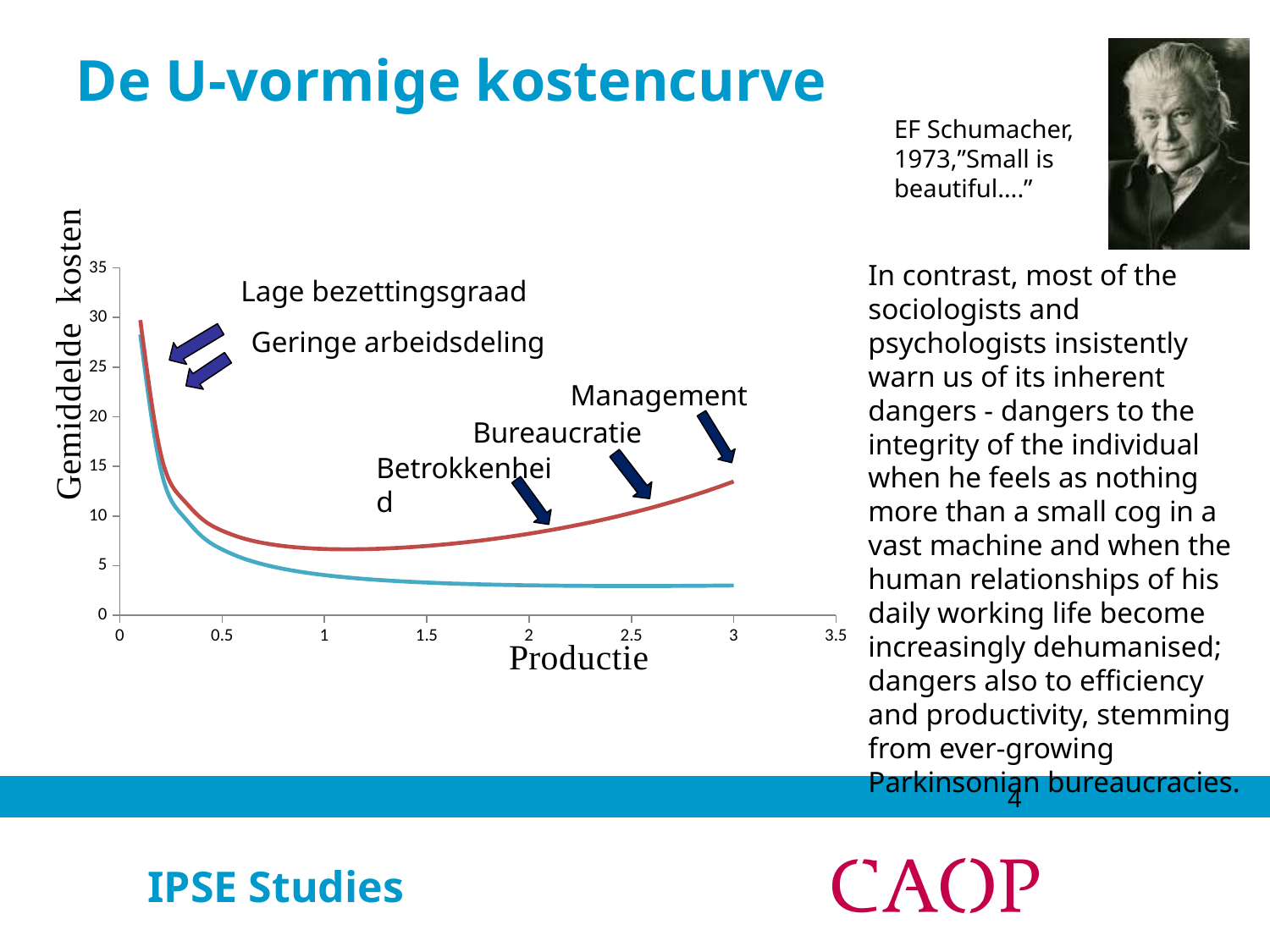
What is the label of the x axis of the chart? Productie Is the value of the blue curve at Productie 2 greater or less than 5? less What is the highest tick value shown on the y axis? 35 Is the value of the red curve at Productie 3 greater or less than 10? greater How many curves are plotted on the chart? 2 Does the red curve rise or fall as Productie increases from 2 to 3? rise At Productie 3, which curve has the higher value, the red or the blue one? red What kind of chart is shown on the slide? line chart Is the value of the blue curve at Productie 3 greater or less than 5? less What is the label of the y axis of the chart? Gemiddelde kosten Does the blue curve rise or fall as Productie increases from 0 to 3? fall